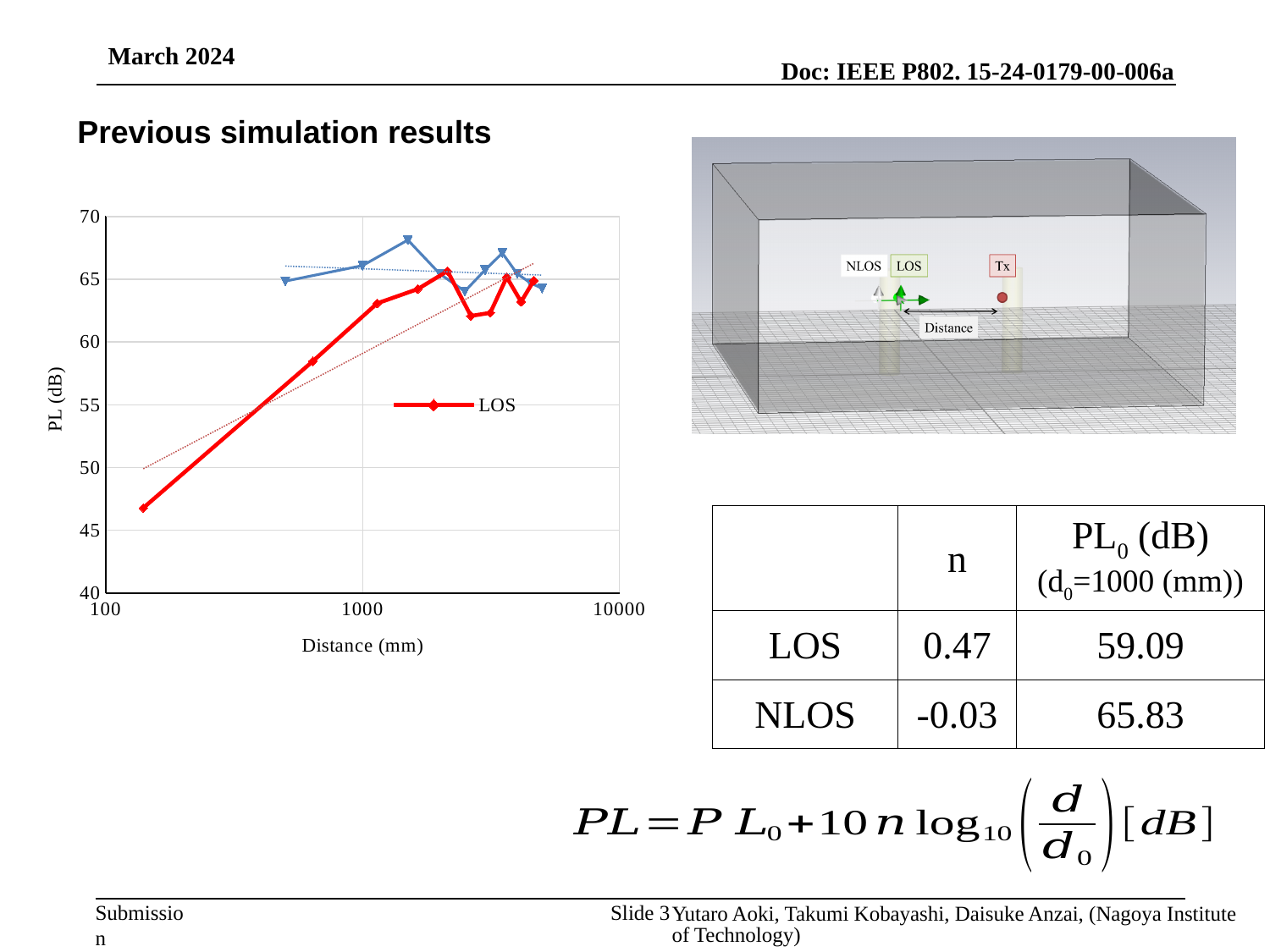
What kind of chart is shown on the slide? line chart Is the value of the red LOS line at its leftmost point (around 140 mm) greater or less than 50? less What is the maximum value shown on the vertical axis of the chart? 70 At 1000 mm, which line has the higher PL value, the red LOS line or the blue line? the blue line Is the value of the red LOS line at about 650 mm greater or less than 55? greater How many series does the chart's legend list? 1 Is the highest point of the blue line greater or less than 65? greater What is the title of the horizontal axis of the chart? Distance (mm) Does the red LOS line generally rise or fall as distance increases from 100 mm to 2000 mm? rise What is the title of the vertical axis of the chart? PL (dB)